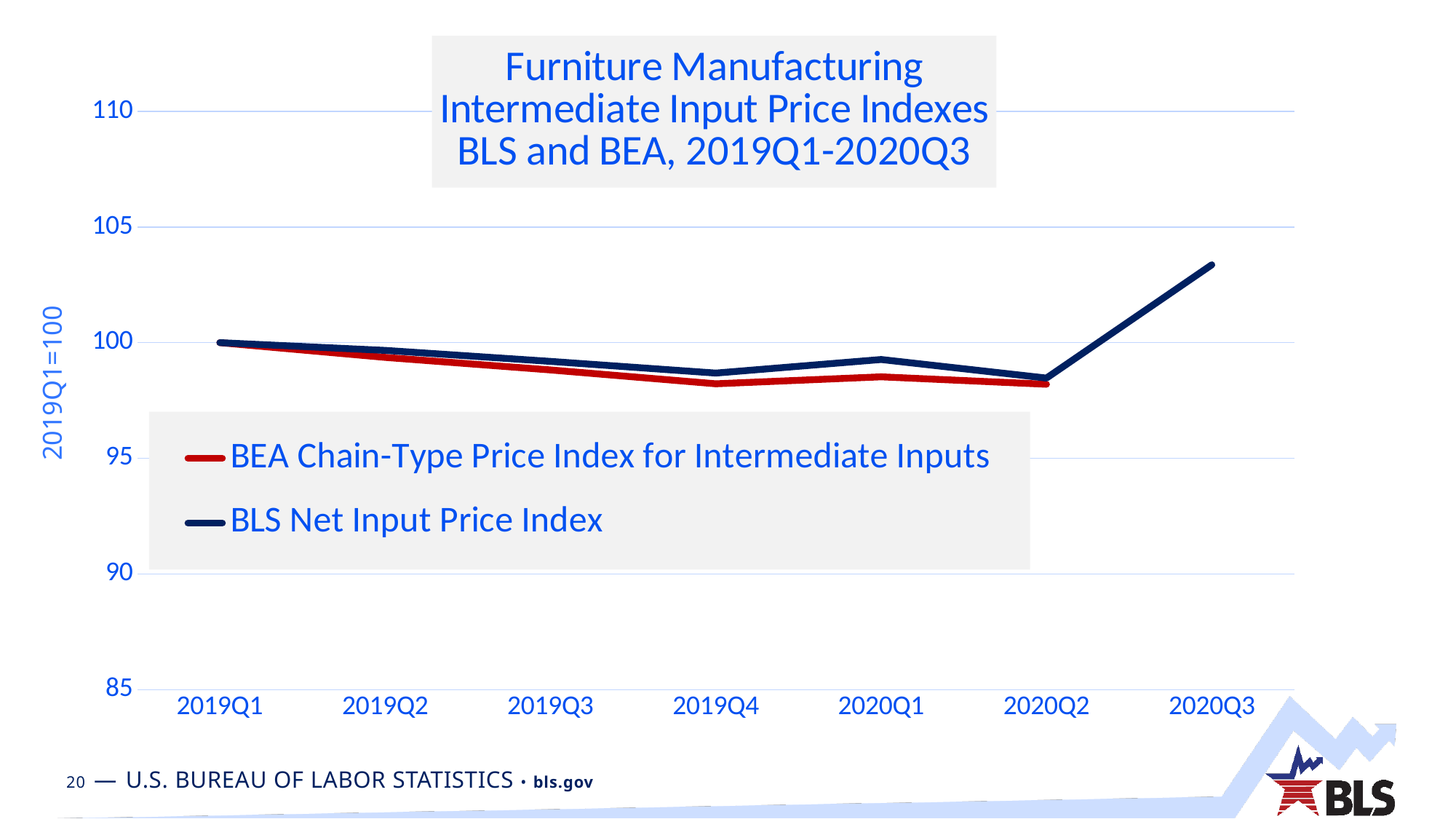
Does the BEA Chain-Type Price Index for Intermediate Inputs rise or fall from 2019Q1 to 2019Q4? fall In which quarter does the BLS Net Input Price Index reach its highest value? 2020Q3 How many series does the legend list? 2 What is the label on the y axis of the chart? 2019Q1=100 What is the value of the BLS Net Input Price Index in 2019Q1? 100 Does the BLS Net Input Price Index rise or fall from 2020Q2 to 2020Q3? rise Is the value of the BLS Net Input Price Index in 2020Q3 greater or less than 105? less How many quarters are shown on the x axis? 7 Is the value of the BEA Chain-Type Price Index for Intermediate Inputs in 2019Q4 greater or less than 100? less What kind of chart is shown on the slide? line chart In 2019Q4, which series has the higher value, the BEA Chain-Type Price Index or the BLS Net Input Price Index? BLS Net Input Price Index Is the value of the BLS Net Input Price Index in 2020Q3 greater or less than 100? greater